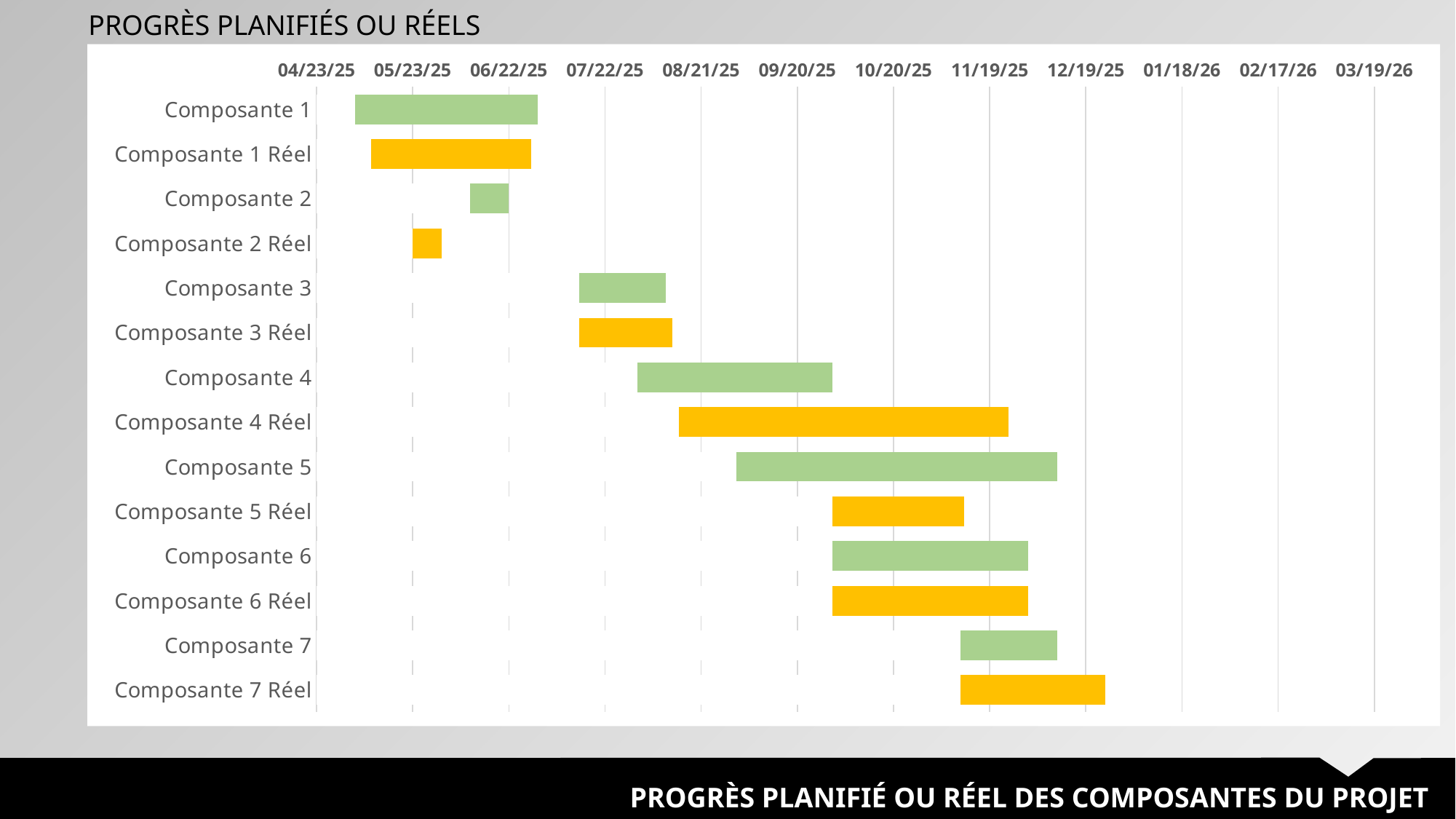
Which row's bar ends latest on the timeline? Composante 7 Réel What is the title of the chart? PROGRÈS PLANIFIÉS OU RÉELS Does the bar for Composante 5 Réel start before or after 09/20/25? after What colour are the bars for the 'Réel' rows? Yellow/orange Does the bar for Composante 7 Réel end before or after 12/19/25? after What kind of chart is shown on the slide? Bar chart (Gantt chart) Does the bar for Composante 4 Réel end before or after 11/19/25? after Which bar is longer, Composante 5 or Composante 5 Réel? Composante 5 Which bar is longer, Composante 4 or Composante 4 Réel? Composante 4 Réel Which row has the shortest bar? Composante 2 Réel How many rows (categories) are listed on the vertical axis of the chart? 14